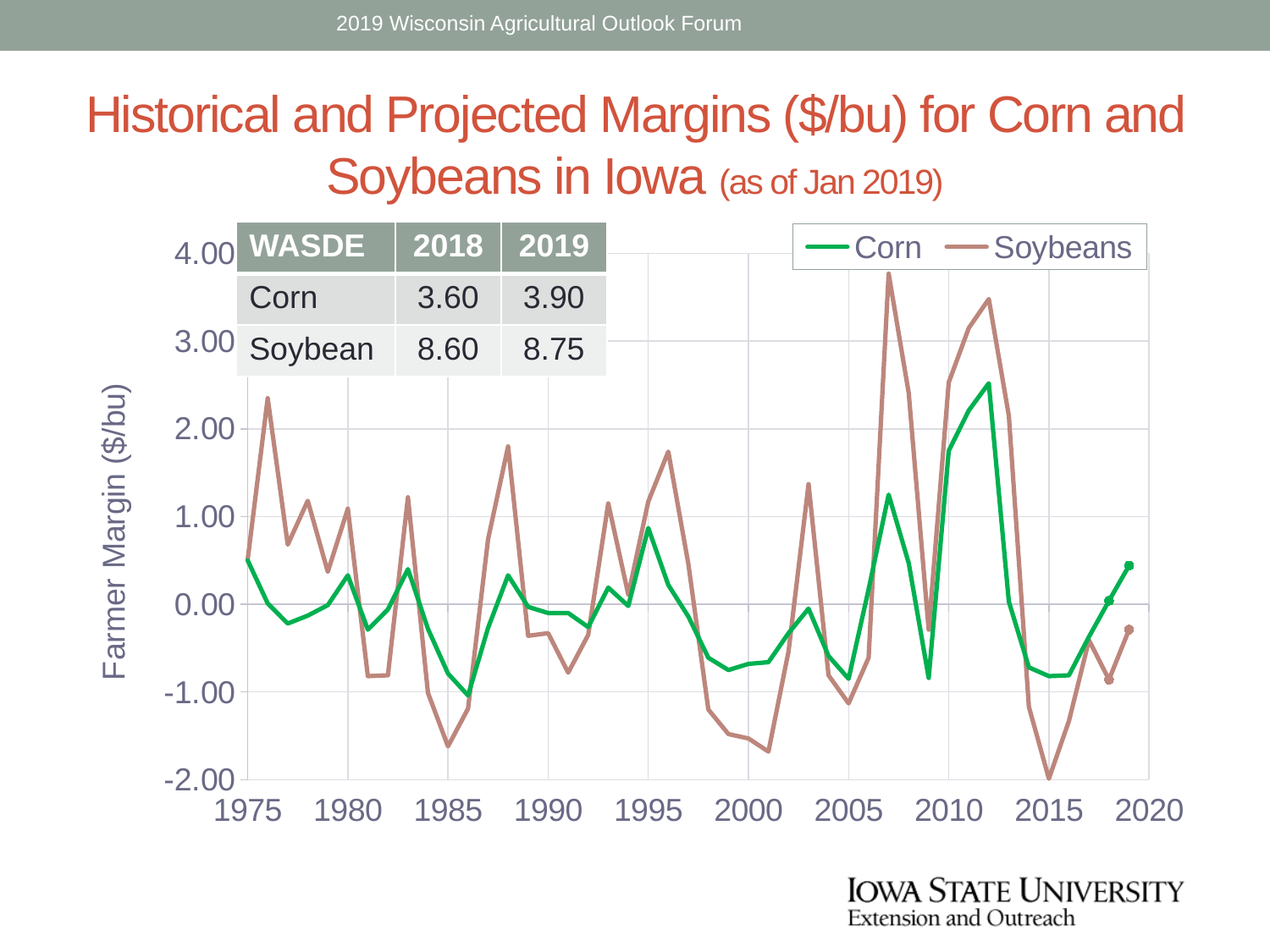
In 2015, which series has the higher margin, Corn or Soybeans? Corn What is the label on the vertical axis of the chart? Farmer Margin ($/bu) In 2007, which series has the higher margin, Corn or Soybeans? Soybeans Is the Corn margin in 2012 greater or less than 2.00? greater What kind of chart is shown on the slide? line chart Is the Soybeans margin in 2007 greater or less than 3.00? greater In which year does the Corn line reach its highest value? 2012 Does the Corn margin rise or fall from 2017 to 2019? rise In which year does the Soybeans line reach its highest value? 2007 What are the two series named in the chart legend? Corn and Soybeans Is the Soybeans margin in 2015 greater or less than -1.00? less How many series does the chart legend list? 2